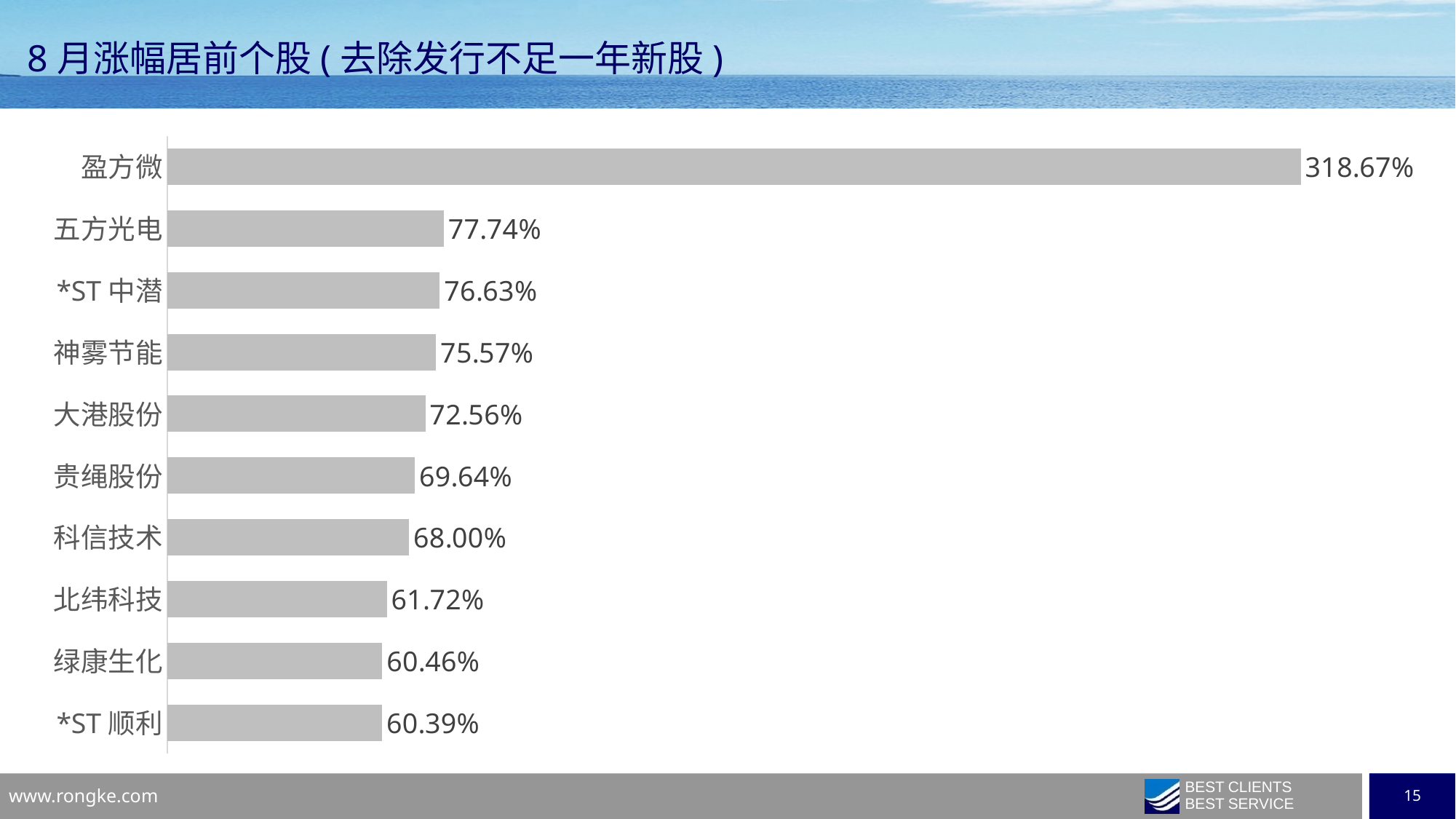
What kind of chart is shown on the slide? bar chart What is the difference between the values for 科信技术 and 绿康生化? 7.54% What is the value for 神雾节能? 75.57% How many stocks are shown in the chart? 10 Which stock has the highest value? 盈方微 What is the difference between the values for 盈方微 and 五方光电? 240.93% What is the title of the slide? 8 月涨幅居前个股 ( 去除发行不足一年新股 ) Which is larger, the value for 大港股份 or the value for 贵绳股份? 大港股份 What is the value for *ST 顺利? 60.39% Which stock has the lowest value? *ST 顺利 What is the value for 盈方微? 318.67% What is the value for 北纬科技? 61.72%